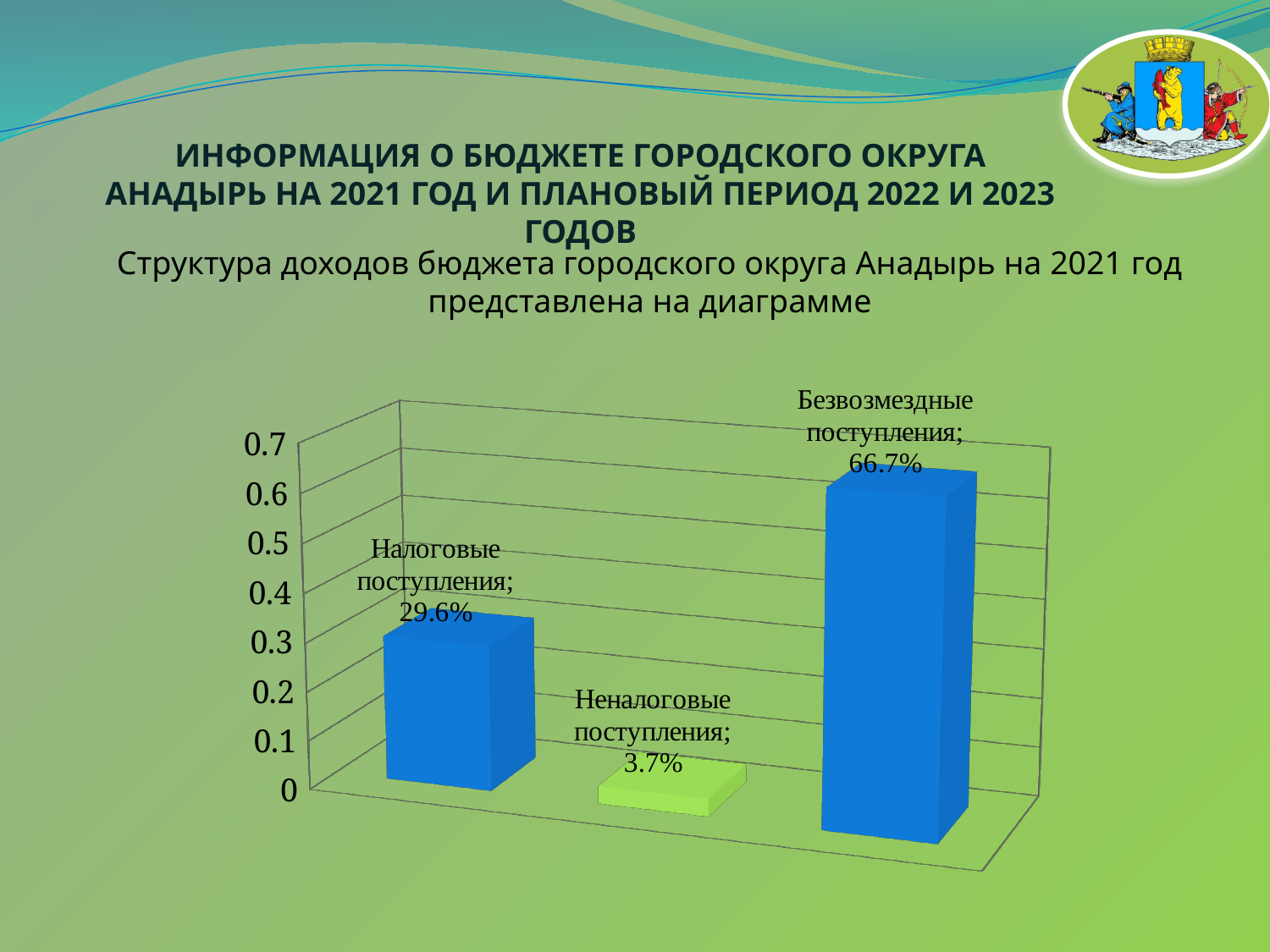
What colour is the bar for Неналоговые поступления? green What is the value for Безвозмездные поступления? 66.7% What is the value for Налоговые поступления? 29.6% Which is larger, Налоговые поступления or Неналоговые поступления? Налоговые поступления How many categories are shown in the chart? 3 Which category has the highest value? Безвозмездные поступления What is the difference between Налоговые поступления and Неналоговые поступления? 25.9% Which category has the lowest value? Неналоговые поступления What is the value for Неналоговые поступления? 3.7% What is the difference between Безвозмездные поступления and Налоговые поступления? 37.1% What kind of chart is shown on the slide? bar chart Is the value for Безвозмездные поступления greater or less than 0.5? greater